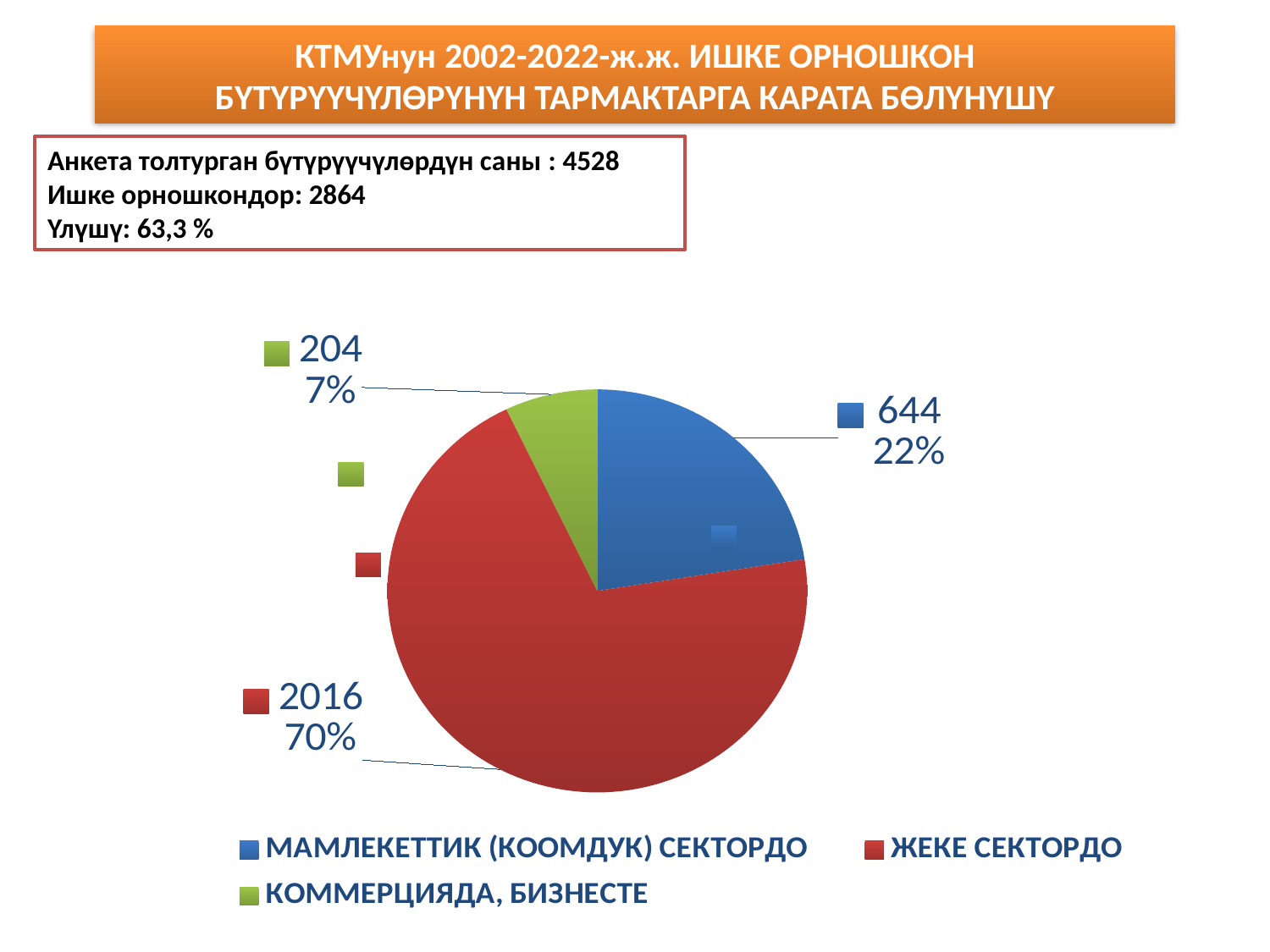
What is the value for МАМЛЕКЕТТИК (КООМДУК) СЕКТОРДО in the pie chart? 644 What is the value for ЖЕКЕ СЕКТОРДО in the pie chart? 2016 How many slices does the pie chart have? 3 Which category has the smallest slice in the pie chart? КОММЕРЦИЯДА, БИЗНЕСТЕ What kind of chart is shown on the slide? pie chart Which category has the largest slice in the pie chart? ЖЕКЕ СЕКТОРДО How many entries does the legend of the pie chart list? 3 What is the value for КОММЕРЦИЯДА, БИЗНЕСТЕ in the pie chart? 204 What share of the pie does МАМЛЕКЕТТИК (КООМДУК) СЕКТОРДО represent? 22% What is the difference between the values for ЖЕКЕ СЕКТОРДО and МАМЛЕКЕТТИК (КООМДУК) СЕКТОРДО? 1372 Which colour represents ЖЕКЕ СЕКТОРДО in the pie chart? red What share of the pie does ЖЕКЕ СЕКТОРДО represent? 70%